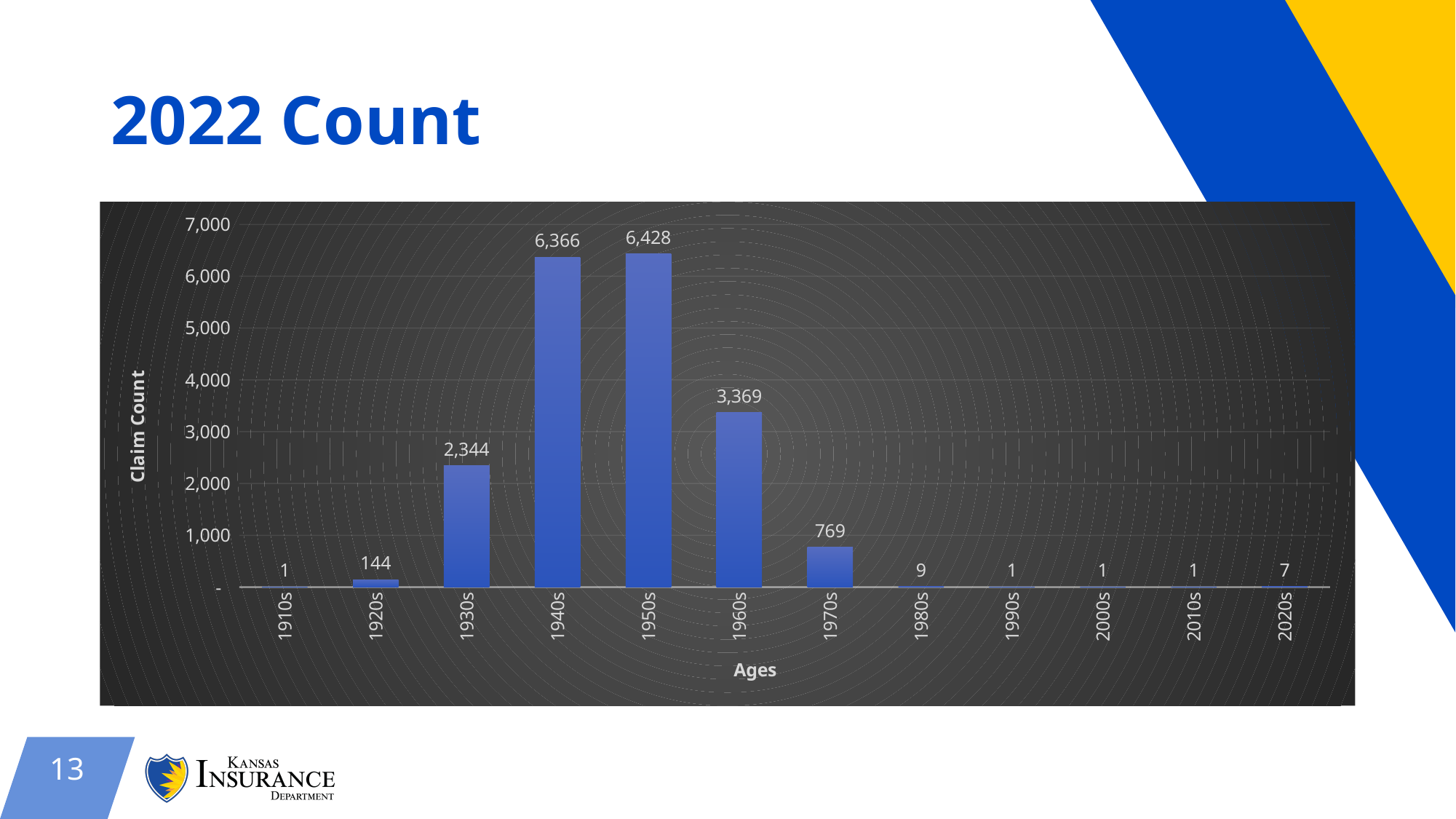
How many age groups are shown on the x axis? 12 Which has a larger claim count, the 1930s or the 1960s age group? 1960s What is the claim count for the 1970s age group? 769 What is the label of the x axis? Ages Which age group has the highest claim count? 1950s What kind of chart is shown on the slide? Bar chart Is the claim count for the 1960s age group greater or less than 3,000? greater What is the claim count for the 1940s age group? 6,366 What is the label of the y axis? Claim Count What is the difference in claim count between the 1950s and 1940s age groups? 62 What is the difference in claim count between the 1960s and 1930s age groups? 1,025 What is the claim count for the 1920s age group? 144